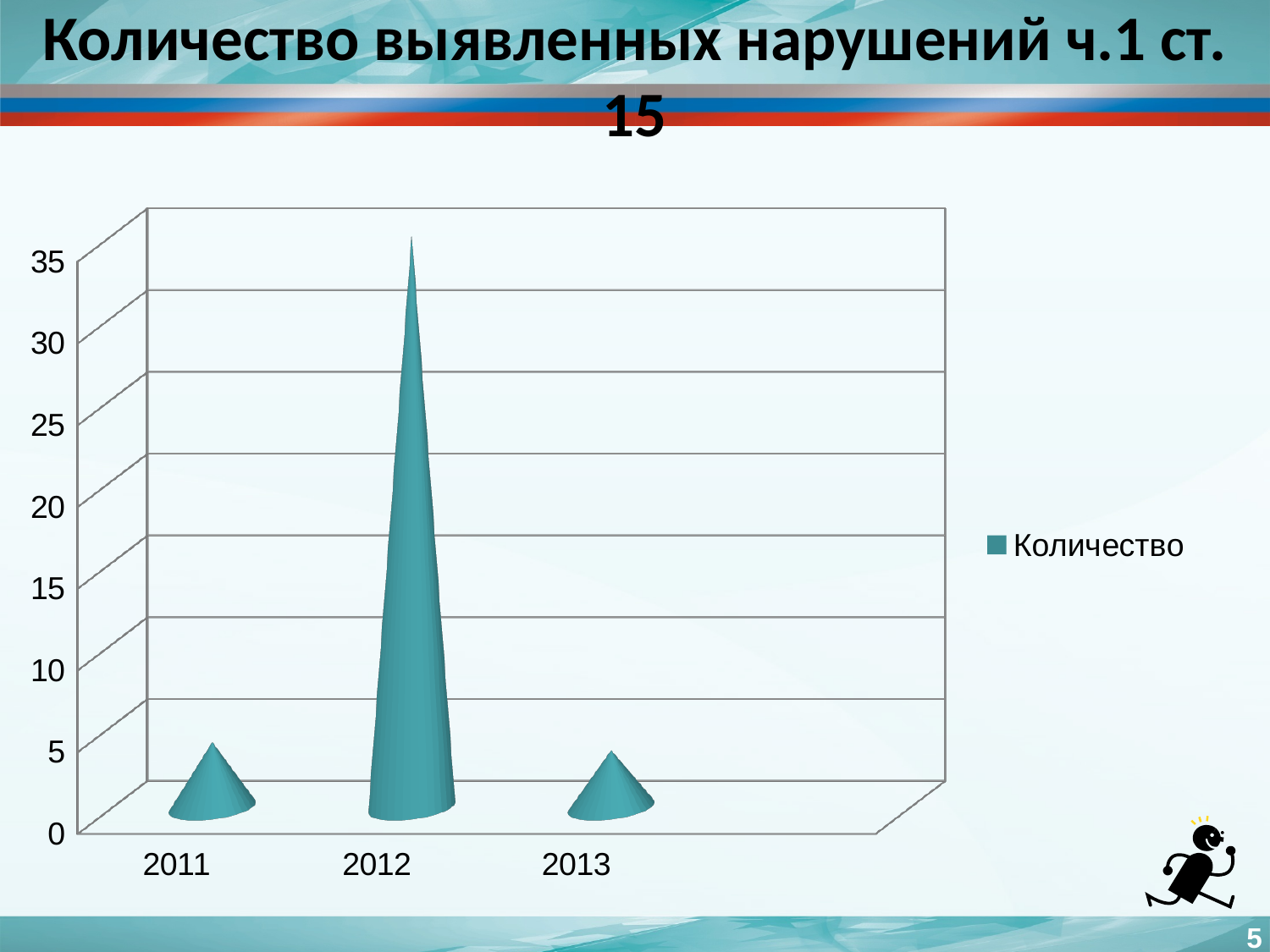
What is the title of the slide containing the chart? Количество выявленных нарушений ч.1 ст. 15 Do the values rise or fall from 2012 to 2013? fall Which year has the highest value in the chart? 2012 How many series does the chart legend list? 1 How many categories (years) are shown on the x axis of the chart? 3 What type of chart is shown on the slide? Bar chart Is the value for 2012 greater or less than 30? greater Is the value for 2011 greater or less than 10? less Which is larger, the value for 2012 or the value for 2013? 2012 What is the name of the series shown in the chart legend? Количество Is the value for 2013 greater or less than 10? less Which is larger, the value for 2011 or the value for 2012? 2012